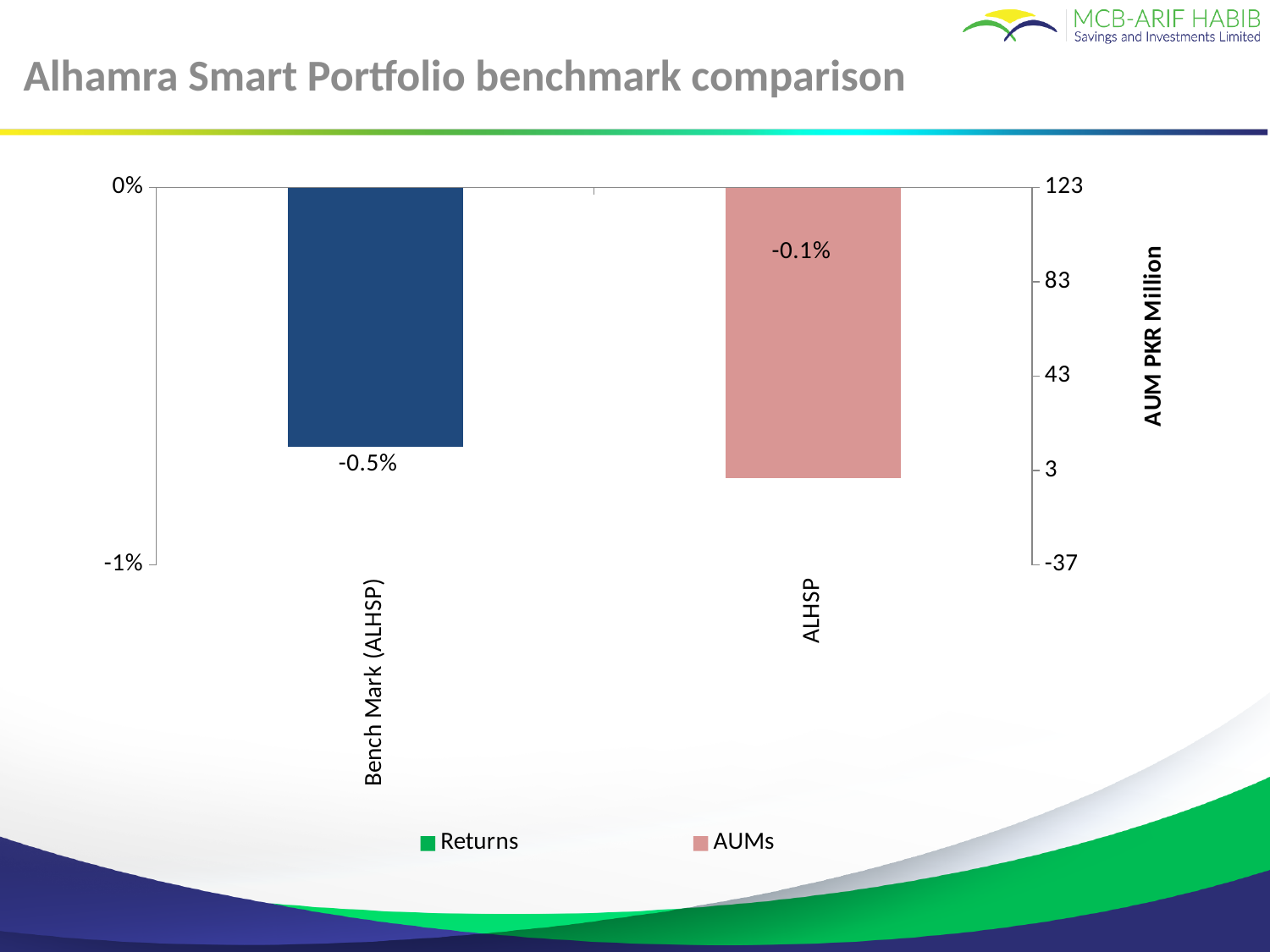
What is the lowest tick value shown on the left vertical axis? -1% What is the title of the slide's chart? Alhamra Smart Portfolio benchmark comparison Which category has the lower (more negative) value, Bench Mark (ALHSP) or ALHSP? Bench Mark (ALHSP) How many series does the legend list? 2 Is the value for ALHSP greater or less than the value for Bench Mark (ALHSP)? greater What is the value shown for Bench Mark (ALHSP)? -0.5% What is the value shown for ALHSP? -0.1% Which category has the higher value, Bench Mark (ALHSP) or ALHSP? ALHSP What is the label of the right-hand (secondary) vertical axis? AUM PKR Million What kind of chart is shown on the slide? Bar chart How many categories are shown on the x axis of the chart? 2 What is the difference in percentage points between the ALHSP value (-0.1%) and the Bench Mark (ALHSP) value (-0.5%)? 0.4 percentage points